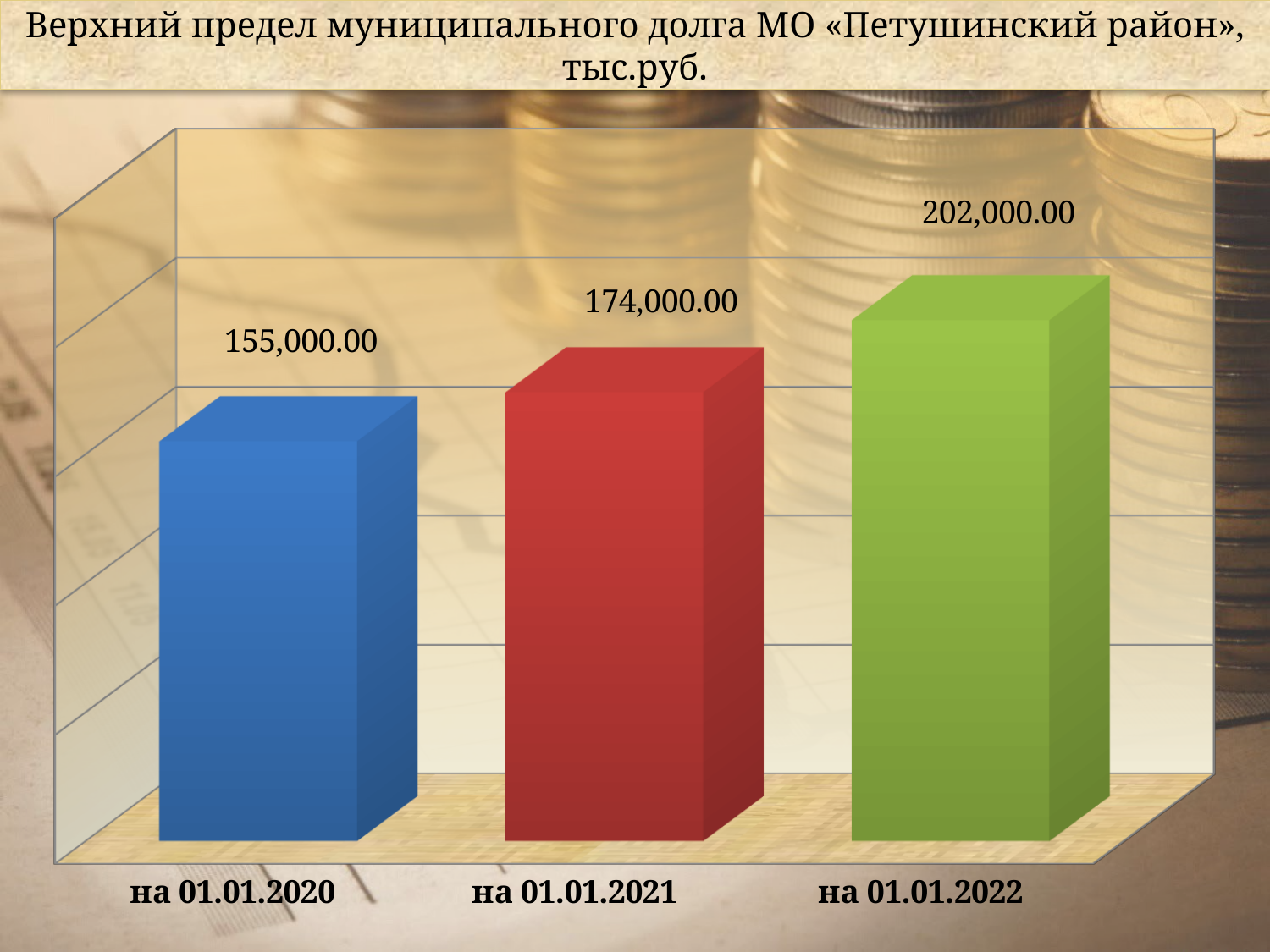
Which category has the highest value? на 01.01.2022 What is the title of the chart? Верхний предел муниципального долга МО «Петушинский район», тыс.руб. How many categories are shown in the chart? 3 What kind of chart is shown on the slide? bar chart Which is larger, the value for на 01.01.2020 or the value for на 01.01.2022? на 01.01.2022 What is the value for на 01.01.2021? 174,000.00 What is the difference between the values for на 01.01.2022 and на 01.01.2021? 28,000.00 What is the value for на 01.01.2022? 202,000.00 What is the value for на 01.01.2020? 155,000.00 Which category has the lowest value? на 01.01.2020 What is the difference between the values for на 01.01.2021 and на 01.01.2020? 19,000.00 Do the values rise or fall from на 01.01.2020 to на 01.01.2022? rise